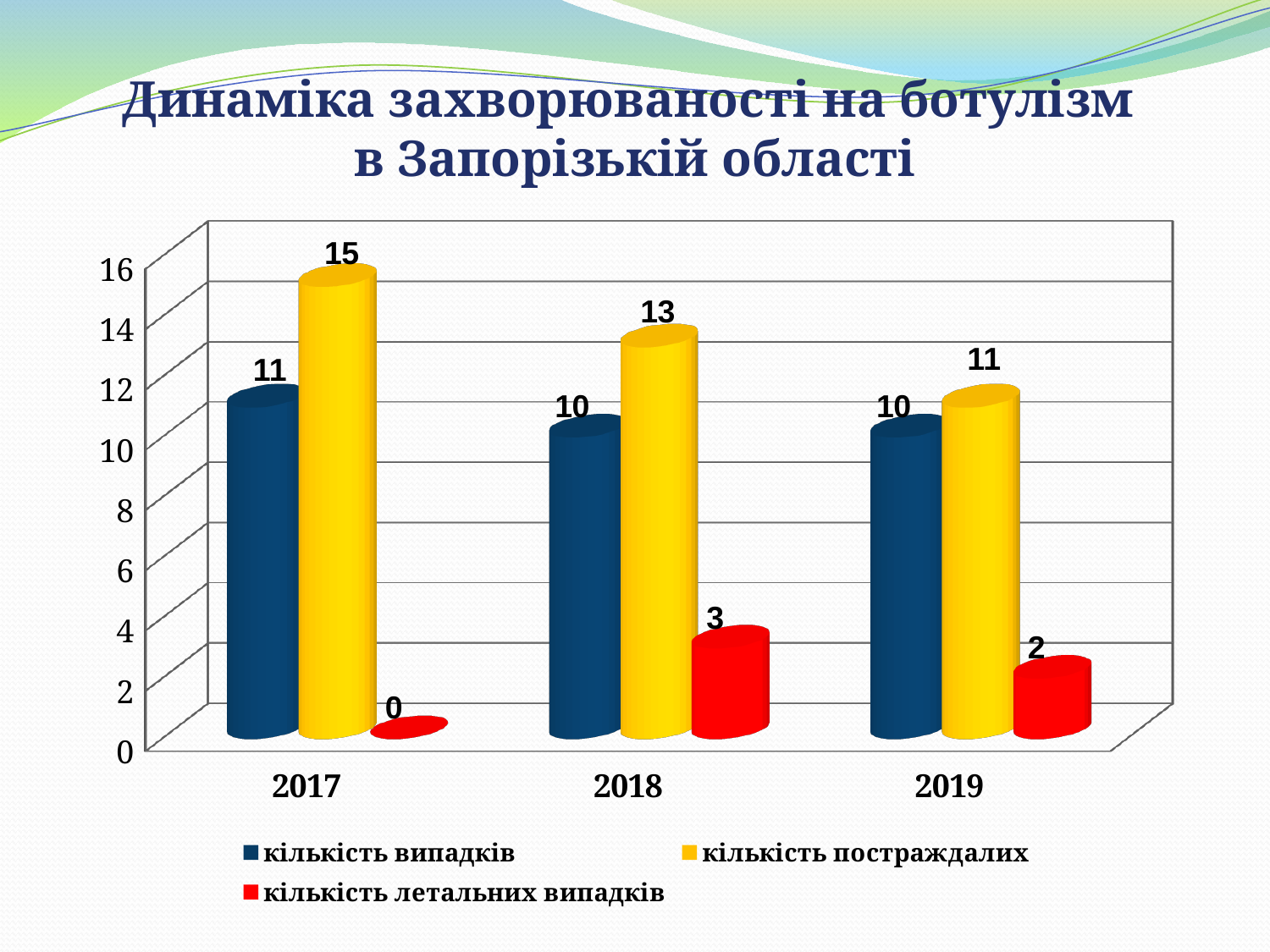
How many years are shown on the x axis? 3 In which year is "кількість постраждалих" highest? 2017 Which is larger in 2019: "кількість випадків" or "кількість постраждалих"? кількість постраждалих What colour are the bars for "кількість летальних випадків"? red What kind of chart is shown on the slide? bar chart Does "кількість постраждалих" rise or fall from 2017 to 2019? fall How many series does the legend list? 3 In which year is "кількість летальних випадків" lowest? 2017 What is the value of "кількість летальних випадків" for 2019? 2 What is the value of "кількість постраждалих" for 2017? 15 What is the value of "кількість випадків" for 2018? 10 What is the difference between "кількість постраждалих" and "кількість випадків" in 2018? 3